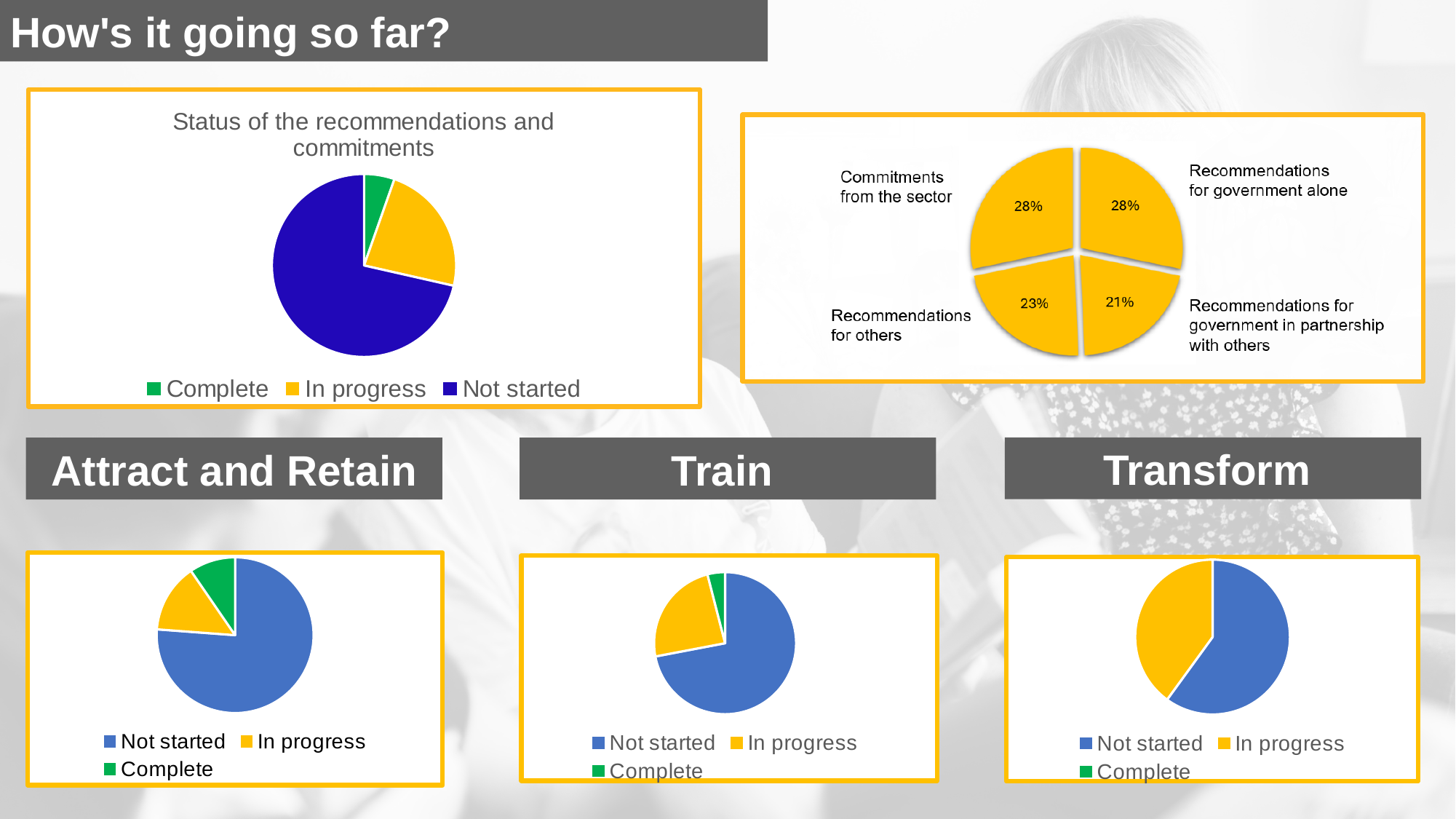
In the top-right pie chart, what percentage is shown for Recommendations for others? 23% What kind of chart is the 'Status of the recommendations and commitments' chart? Pie chart In the 'Transform' pie chart, which is larger, Not started or In progress? Not started In the top-right pie chart, how many slices does the pie have? 4 In the top-right pie chart, what percentage is shown for Commitments from the sector? 28% In the 'Status of the recommendations and commitments' chart, which status has the smallest share? Complete In the 'Status of the recommendations and commitments' chart, which status has the largest share? Not started How many entries does the legend of the 'Status of the recommendations and commitments' chart list? 3 In the top-right pie chart, which category has the smallest share? Recommendations for government in partnership with others In the top-right pie chart, what is the difference in percentage points between Recommendations for government alone and Recommendations for government in partnership with others? 7 In the top-right pie chart, what percentage is shown for Recommendations for government in partnership with others? 21% In the 'Attract and Retain' pie chart, which status has the largest share? Not started